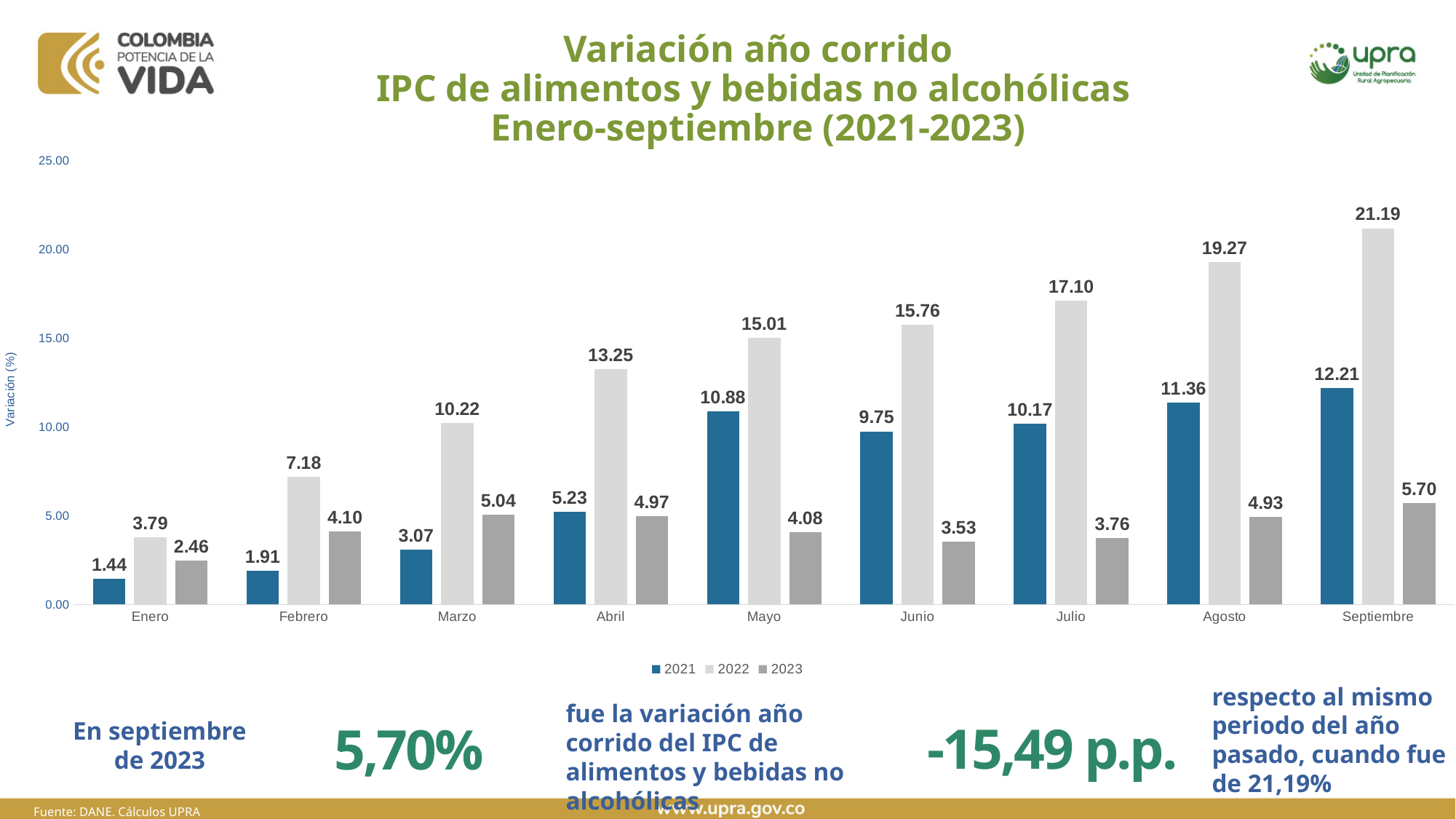
Does the 2022 series rise or fall from Enero to Septiembre? rise In which month is the 2021 series lowest? Enero What is the value for 2021 in Mayo? 10.88 Which is larger in Abril: the 2021 value or the 2023 value? 2021 How many series does the legend list? 3 What is the difference between the 2022 and 2021 values in Septiembre? 8.98 What is the value for 2022 in Septiembre? 21.19 What is the value for 2023 in Abril? 4.97 What is the difference between the 2022 and 2023 values in Septiembre? 15.49 Is the value for 2022 in Agosto greater or less than 15.00? greater In which month does the 2023 series reach its highest value? Septiembre How many months are shown on the x axis? 9